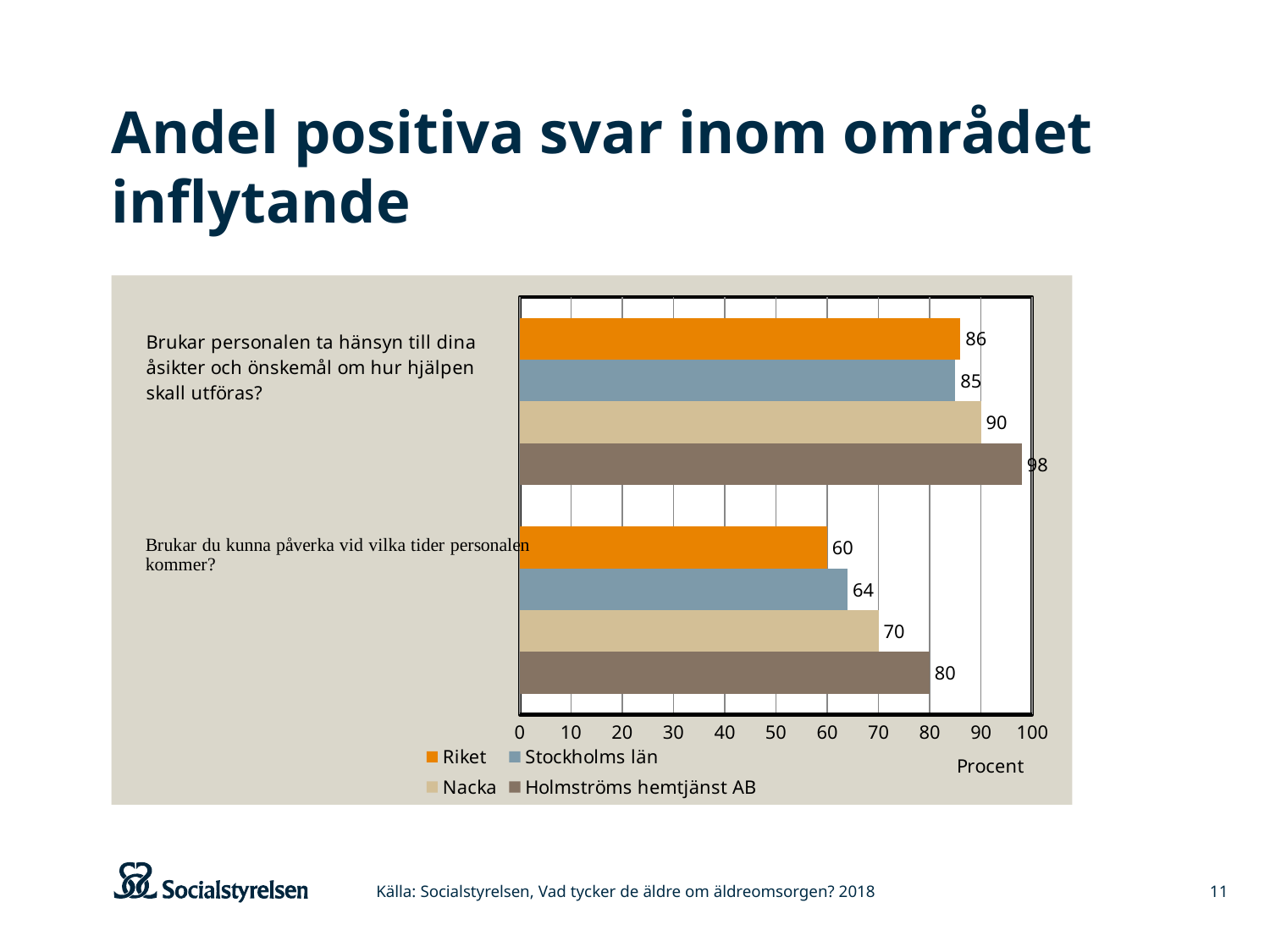
What is the difference between the Nacka value and the Stockholms län value for the question "Brukar personalen ta hänsyn till dina åsikter och önskemål om hur hjälpen skall utföras?"? 5 Which series has the highest value for the question "Brukar du kunna påverka vid vilka tider personalen kommer?"? Holmströms hemtjänst AB What is the value for Holmströms hemtjänst AB for the question "Brukar personalen ta hänsyn till dina åsikter och önskemål om hur hjälpen skall utföras?"? 98 What is the label on the horizontal axis of the chart? Procent Which is larger for the question "Brukar du kunna påverka vid vilka tider personalen kommer?": the value for Riket or the value for Stockholms län? Stockholms län How many series does the legend list? 4 What kind of chart is shown on the slide? Bar chart Which series has the lowest value for the question "Brukar personalen ta hänsyn till dina åsikter och önskemål om hur hjälpen skall utföras?"? Stockholms län What is the value for Stockholms län for the question "Brukar personalen ta hänsyn till dina åsikter och önskemål om hur hjälpen skall utföras?"? 85 What is the value for Riket for the question "Brukar du kunna påverka vid vilka tider personalen kommer?"? 60 What is the difference between the Holmströms hemtjänst AB value and the Riket value for the question "Brukar du kunna påverka vid vilka tider personalen kommer?"? 20 What is the value for Nacka for the question "Brukar du kunna påverka vid vilka tider personalen kommer?"? 70